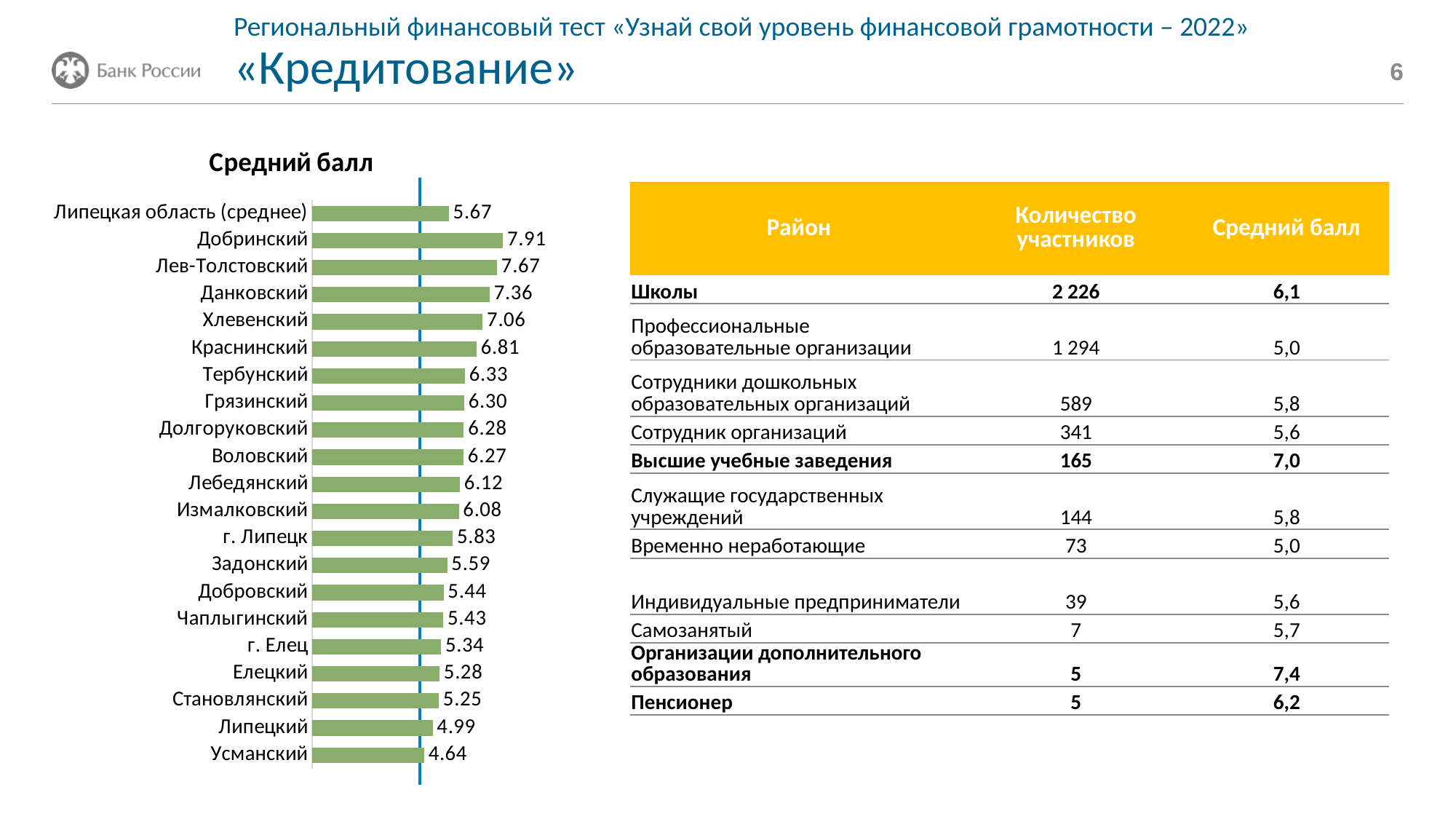
What is the title of the chart? Средний балл What is the average score for г. Елец? 5.34 What is the average score for Добринский? 7.91 Which district has the lowest average score? Усманский What is the difference between the average score of Лев-Толстовский and the regional average (Липецкая область (среднее))? 2.00 What is the difference between the average scores of Добринский and Усманский? 3.27 Which has a higher average score, Данковский or Хлевенский? Данковский What is the average score for Липецкая область (среднее)? 5.67 Which district has the highest average score? Добринский What type of chart is shown on the slide? Bar chart How many categories (bars) are shown in the chart? 21 Do the district values rise or fall going down the chart from Добринский to Усманский? Fall